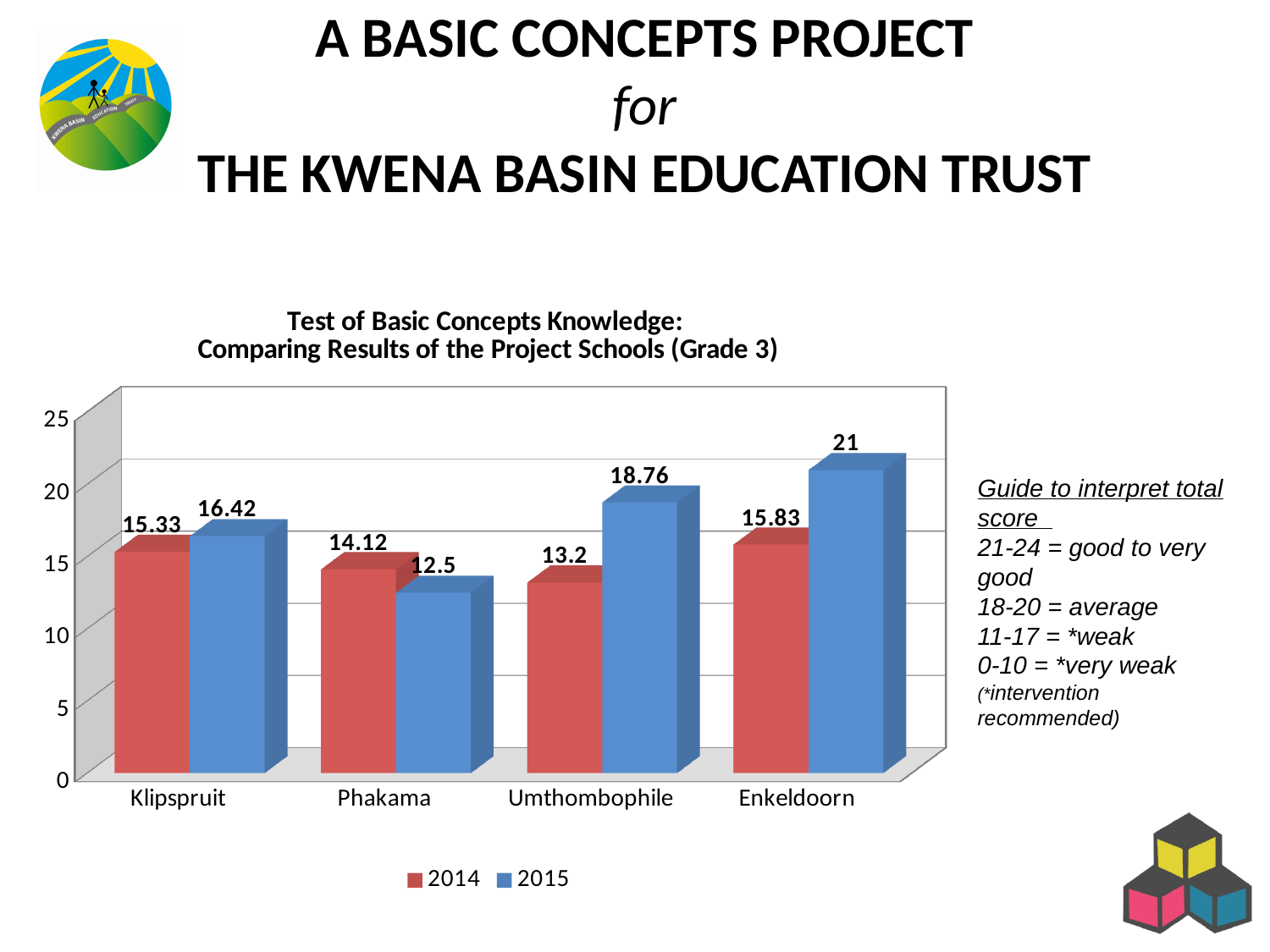
What is the difference between the 2015 and 2014 scores for Umthombophile? 5.56 What was the 2014 score for Phakama? 14.12 What is the difference between the 2015 scores of Enkeldoorn and Klipspruit? 4.58 What kind of chart is shown? Bar chart Which was larger for Phakama, the 2014 score or the 2015 score? 2014 How many schools are shown on the x axis? 4 What was the 2015 score for Umthombophile? 18.76 What was the 2015 score for Enkeldoorn? 21 Which school had the highest 2015 score? Enkeldoorn Which colour represents 2015 in the chart? Blue Which school had the lowest 2014 score? Umthombophile How many series does the legend list? 2